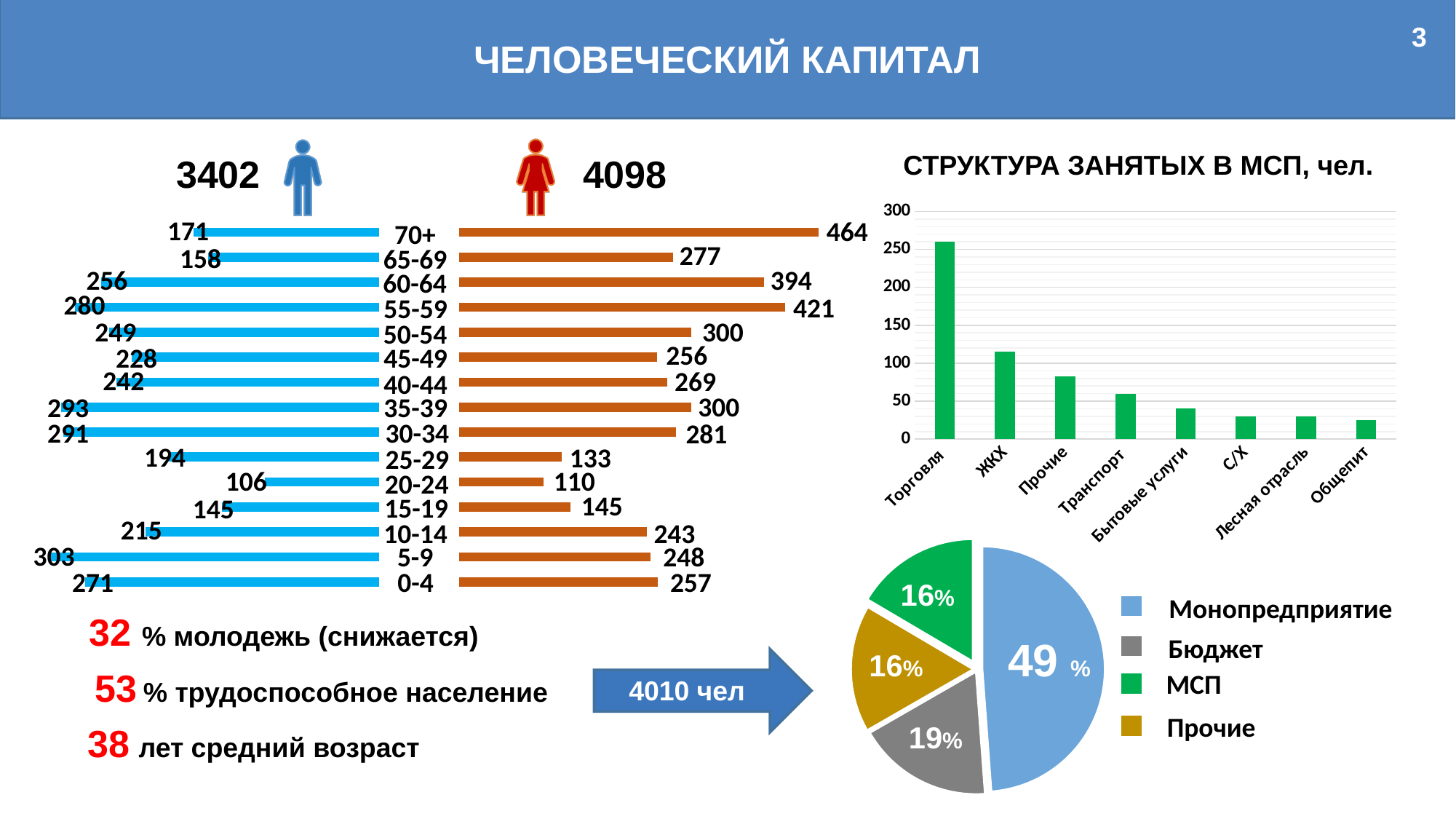
In the chart titled 'СТРУКТУРА ЗАНЯТЫХ В МСП, чел.', is the value for ЖКХ greater or less than 100? greater In the chart titled 'СТРУКТУРА ЗАНЯТЫХ В МСП, чел.', how many categories are shown? 8 In the population pyramid on the left, what is the difference between the women's and men's values in the 70+ age group? 293 In the population pyramid on the left, what is the value for men in the 70+ age group? 171 In the chart titled 'СТРУКТУРА ЗАНЯТЫХ В МСП, чел.', which category has the highest value? Торговля In the population pyramid on the left, which age group has the lowest value for men? 20-24 In the pie chart at the bottom right, how many entries does the legend list? 4 In the population pyramid on the left, which age group has the highest value for women? 70+ In the pie chart at the bottom right, what share does Бюджет have? 19% In the chart titled 'СТРУКТУРА ЗАНЯТЫХ В МСП, чел.', what kind of chart is it? bar chart In the population pyramid on the left, how many age groups are shown? 15 In the population pyramid on the left, what is the value for women in the 55-59 age group? 421